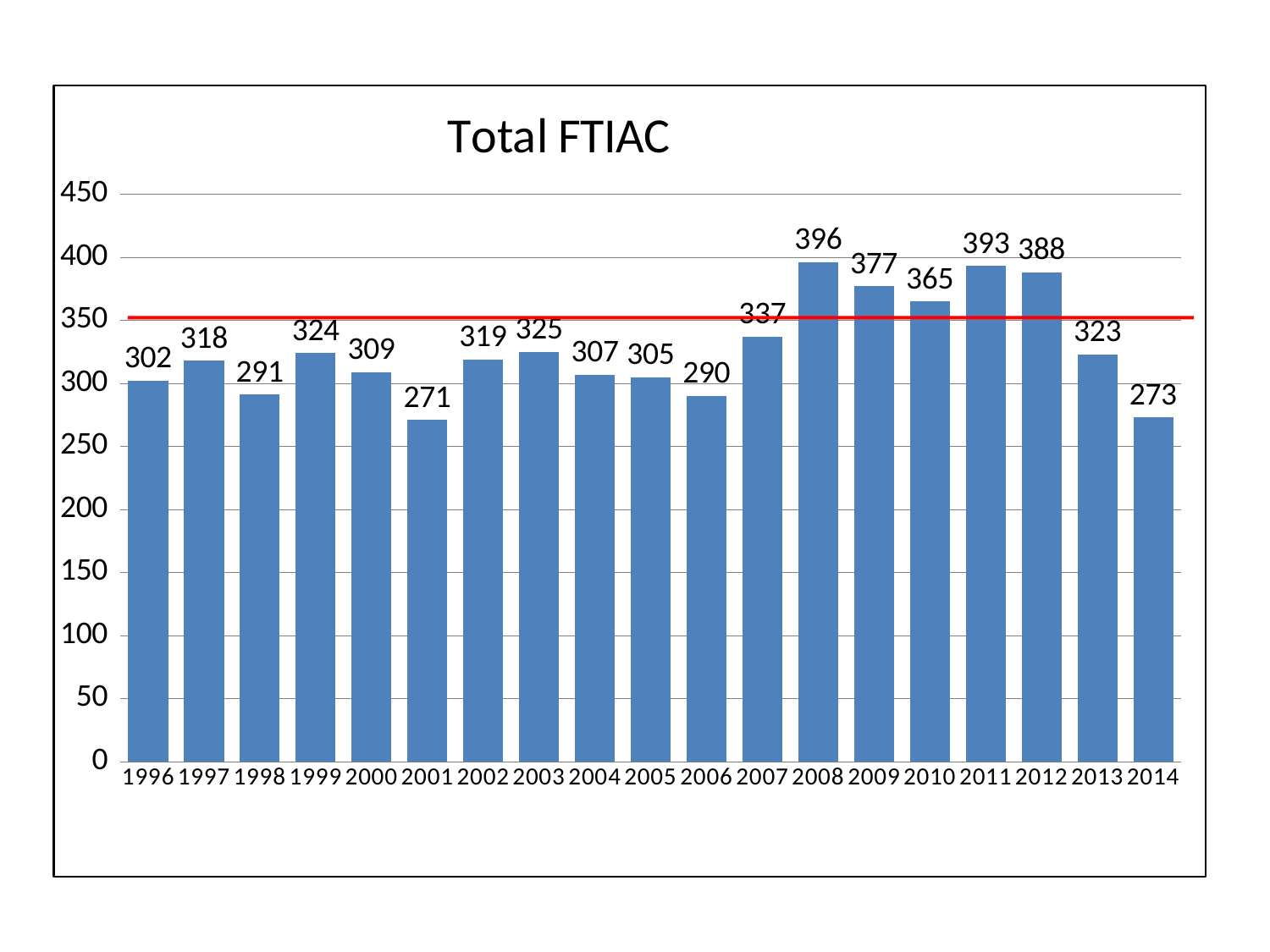
What is the value for 2008? 396 What is the title of the chart? Total FTIAC Which year has the highest value? 2008 What is the difference between the values for 2008 and 2001? 125 What is the difference between the values for 2012 and 2013? 65 What is the value for 2014? 273 How many years are shown on the x axis? 19 Which year has the lowest value? 2001 Which is larger, the value for 2011 or the value for 2009? 2011 What is the value for 2001? 271 Do the values rise or fall from 2012 to 2014? fall What kind of chart is this? bar chart